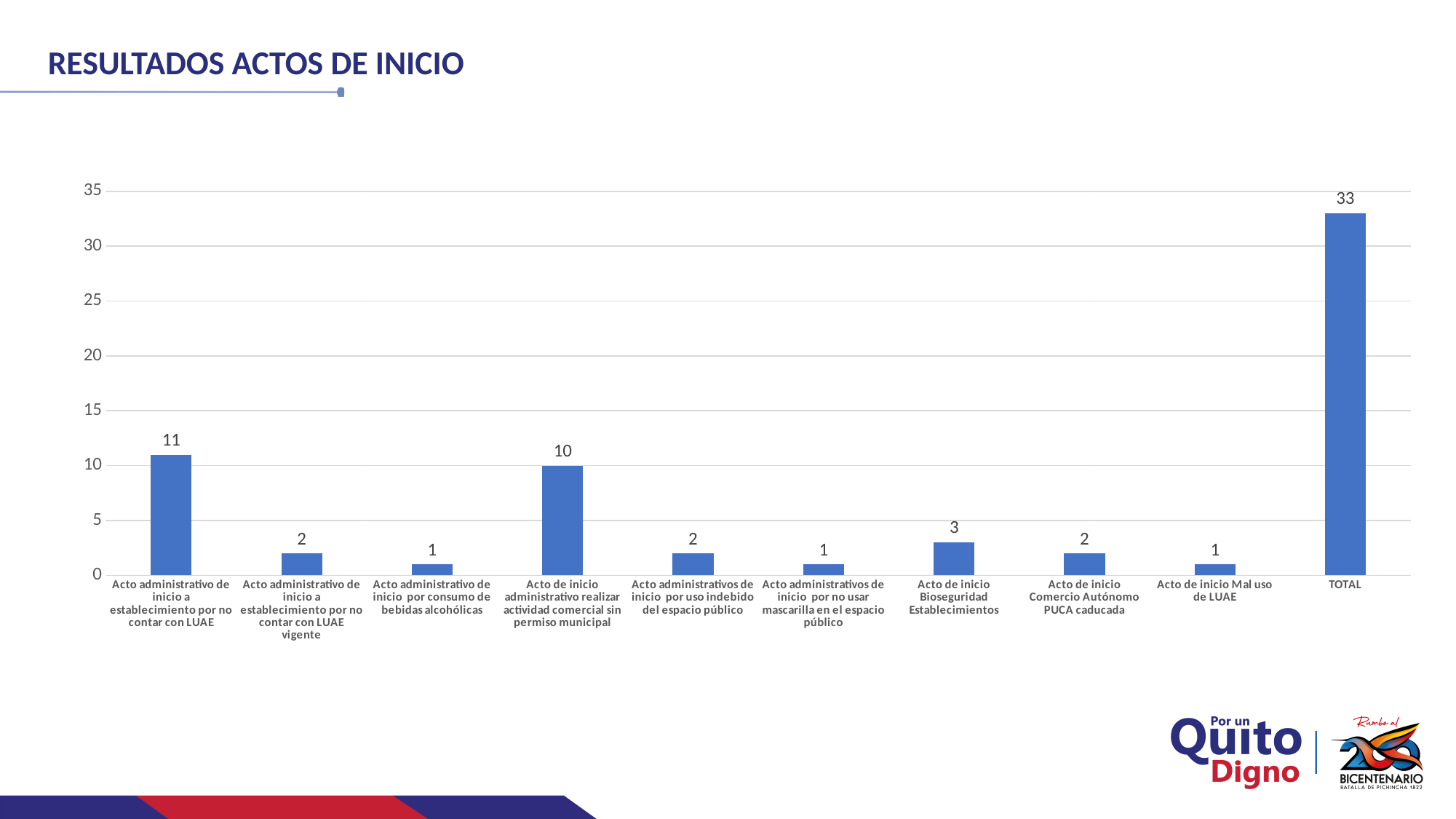
What is the value for 'Acto de inicio Mal uso de LUAE'? 1 What is the value for 'Acto de inicio Bioseguridad Establecimientos'? 3 What is the difference between the value for 'Acto administrativo de inicio a establecimiento por no contar con LUAE' and the value for 'Acto de inicio administrativo realizar actividad comercial sin permiso municipal'? 1 What is the title of the slide? RESULTADOS ACTOS DE INICIO What is the value for 'Acto de inicio administrativo realizar actividad comercial sin permiso municipal'? 10 What is the value for 'Acto administrativo de inicio a establecimiento por no contar con LUAE'? 11 Which is larger: the value for 'Acto de inicio Bioseguridad Establecimientos' or the value for 'Acto de inicio Comercio Autónomo PUCA caducada'? Acto de inicio Bioseguridad Establecimientos What is the value for TOTAL? 33 How many bars are shown in the chart, including TOTAL? 10 Is the value for TOTAL greater or less than 30? greater What kind of chart is shown on the slide? bar chart Excluding the TOTAL bar, which category has the highest value? Acto administrativo de inicio a establecimiento por no contar con LUAE